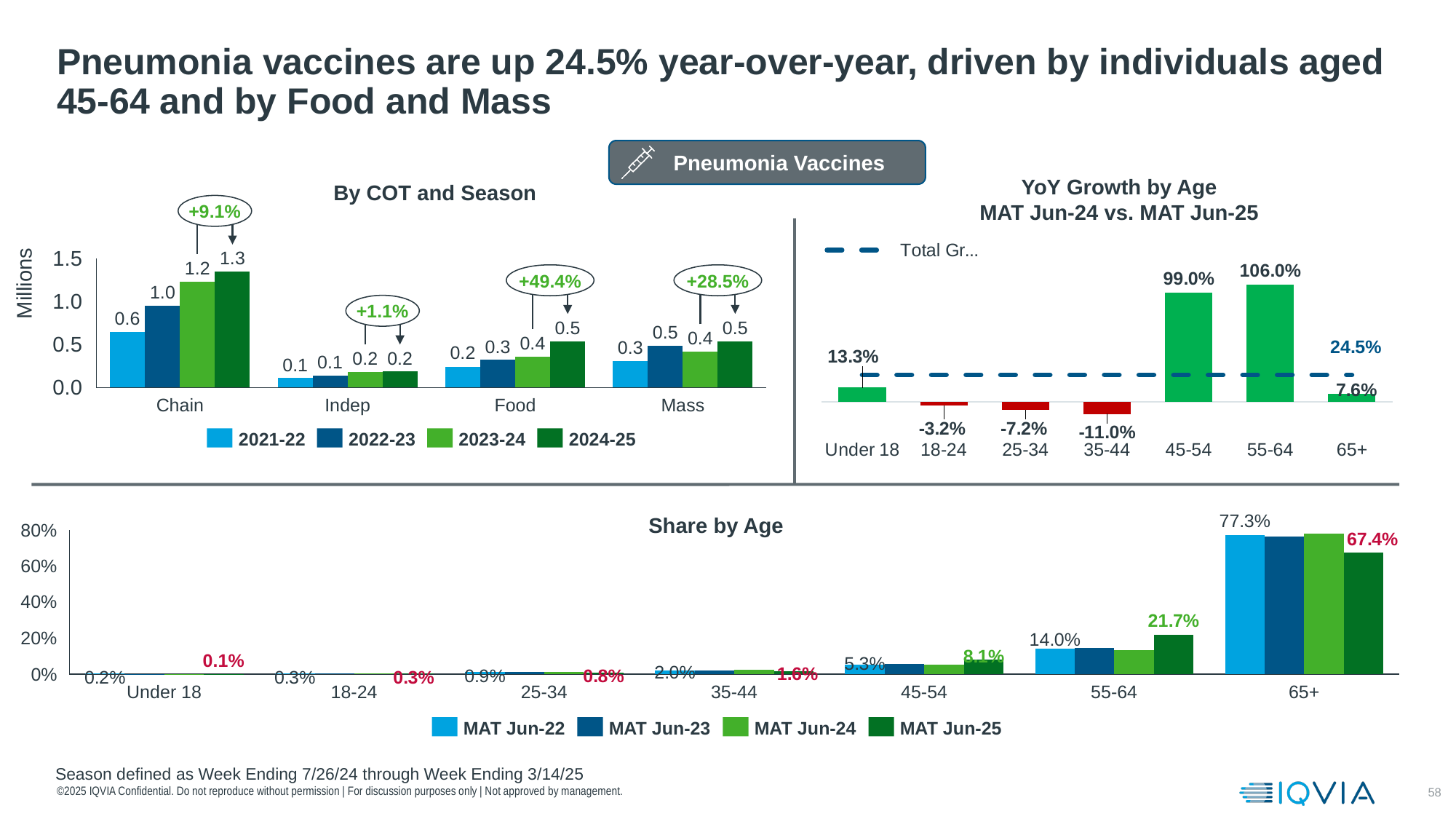
In the 'YoY Growth by Age' chart, what total growth value is marked by the dashed line? 24.5% In the 'By COT and Season' chart, what is the difference between the Chain values for 2024-25 and 2021-22? 0.7 How many age groups are shown in the 'YoY Growth by Age' chart? 7 In the 'YoY Growth by Age' chart, which age group has the lowest growth? 35-44 In the 'Share by Age' chart, which is larger for the 55-64 age group: the MAT Jun-22 share or the MAT Jun-25 share? MAT Jun-25 In the 'By COT and Season' chart, which channel has the highest 2024-25 value? Chain How many series does the legend of the 'By COT and Season' chart list? 4 In the 'YoY Growth by Age' chart, what is the value for the 55-64 age group? 106.0% In the 'By COT and Season' chart, what growth percentage is shown in the callout above Food? +49.4% In the 'Share by Age' chart, what is the MAT Jun-25 share for the 65+ age group? 67.4% In the 'By COT and Season' chart, what is the value for Chain in 2024-25? 1.3 What type of chart is the 'Share by Age' chart? Bar chart